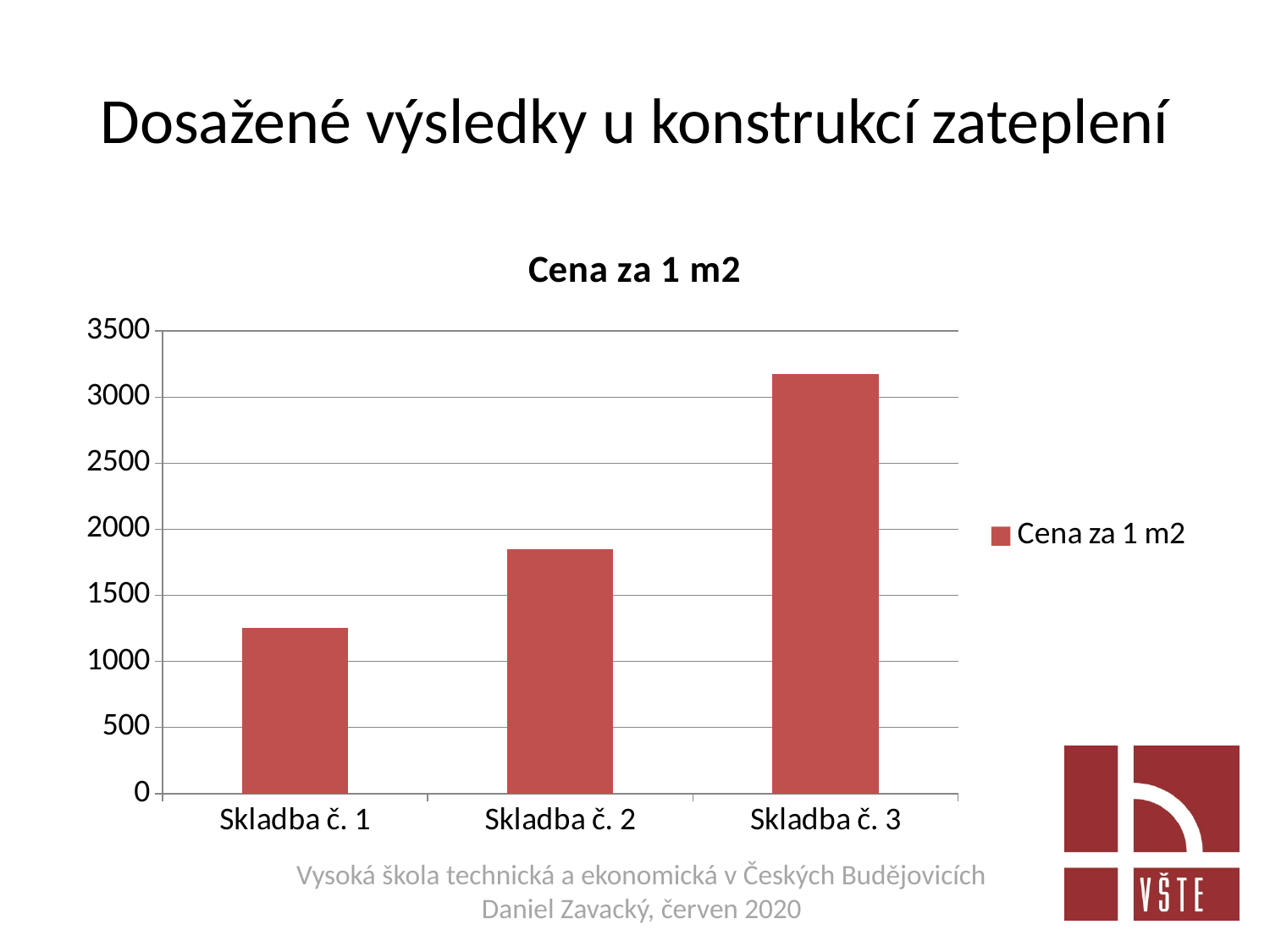
Do the values rise or fall from Skladba č. 1 to Skladba č. 3? rise Which category has the highest value? Skladba č. 3 Is the value for Skladba č. 1 greater or less than 1500? less What kind of chart is shown on the slide? bar chart How many series does the legend list? 1 What is the title of the chart? Cena za 1 m2 Which is larger, the value for Skladba č. 2 or Skladba č. 3? Skladba č. 3 What is the legend entry shown on the chart? Cena za 1 m2 Which category has the lowest value? Skladba č. 1 Is the value for Skladba č. 2 greater or less than 1500? greater How many categories are shown on the x axis of the chart? 3 Is the value for Skladba č. 3 greater or less than 3000? greater